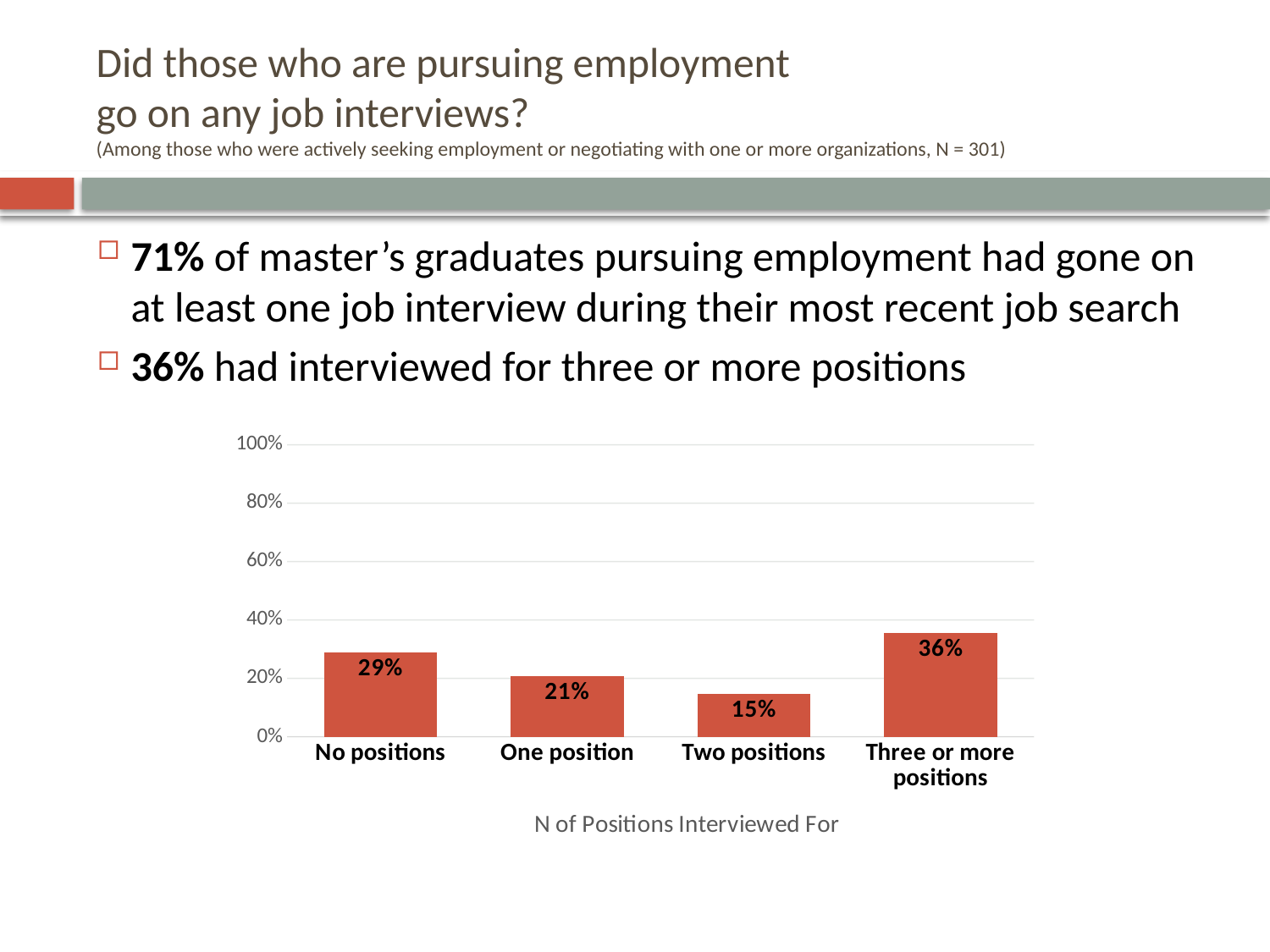
What is the difference between the values for 'Three or more positions' and 'No positions'? 7% What is the value for 'Three or more positions'? 36% Which category has the highest value? Three or more positions What kind of chart is shown on the slide? bar chart Which is larger, the value for 'No positions' or the value for 'One position'? No positions What is the difference between the values for 'One position' and 'Two positions'? 6% What is the value for 'No positions'? 29% What is the value for 'Two positions'? 15% What is the value for 'One position'? 21% Which category has the lowest value? Two positions Is the value for 'Three or more positions' greater or less than 40%? less How many categories are shown on the x axis? 4